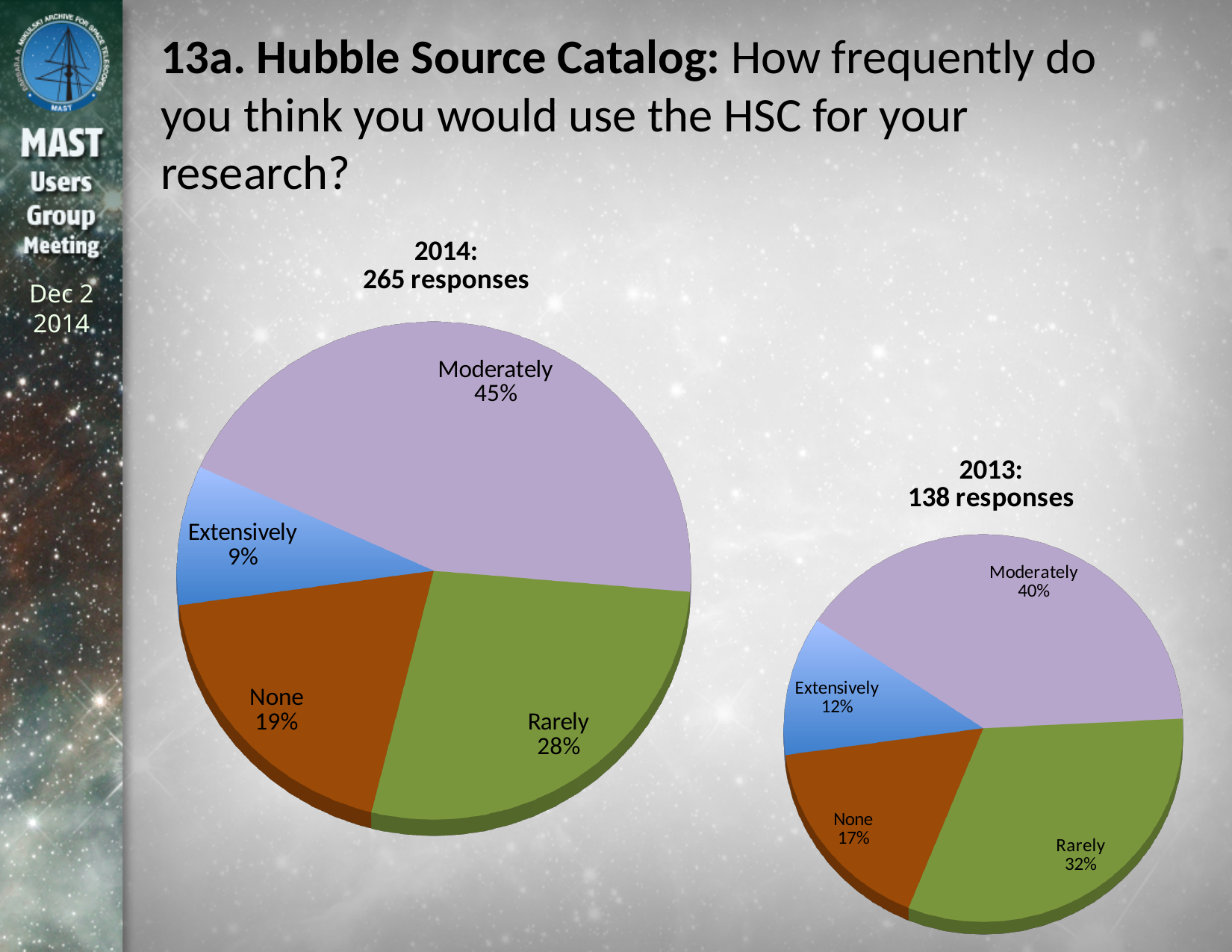
How many responses does the 2014 chart title say were received? 265 responses In the 2013 pie chart, what percentage of responses were 'Rarely'? 32% In the 2014 pie chart, what is the difference between the 'Rarely' and 'None' shares? 9% In the 2013 pie chart, which category has the smallest share? Extensively In the 2013 pie chart, what colour is the 'Moderately' slice? Purple What type of chart is used to show the 2014 responses? Pie chart In the 2014 pie chart, what percentage of responses were 'Extensively'? 9% In the 2014 pie chart, which category has the largest share? Moderately Which is larger: the 'Extensively' share in 2013 or the 'Extensively' share in 2014? 2013 In the 2014 pie chart, what percentage of responses were 'Moderately'? 45% How many categories are shown in the 2013 pie chart? 4 In the 2013 pie chart, what percentage of responses were 'None'? 17%